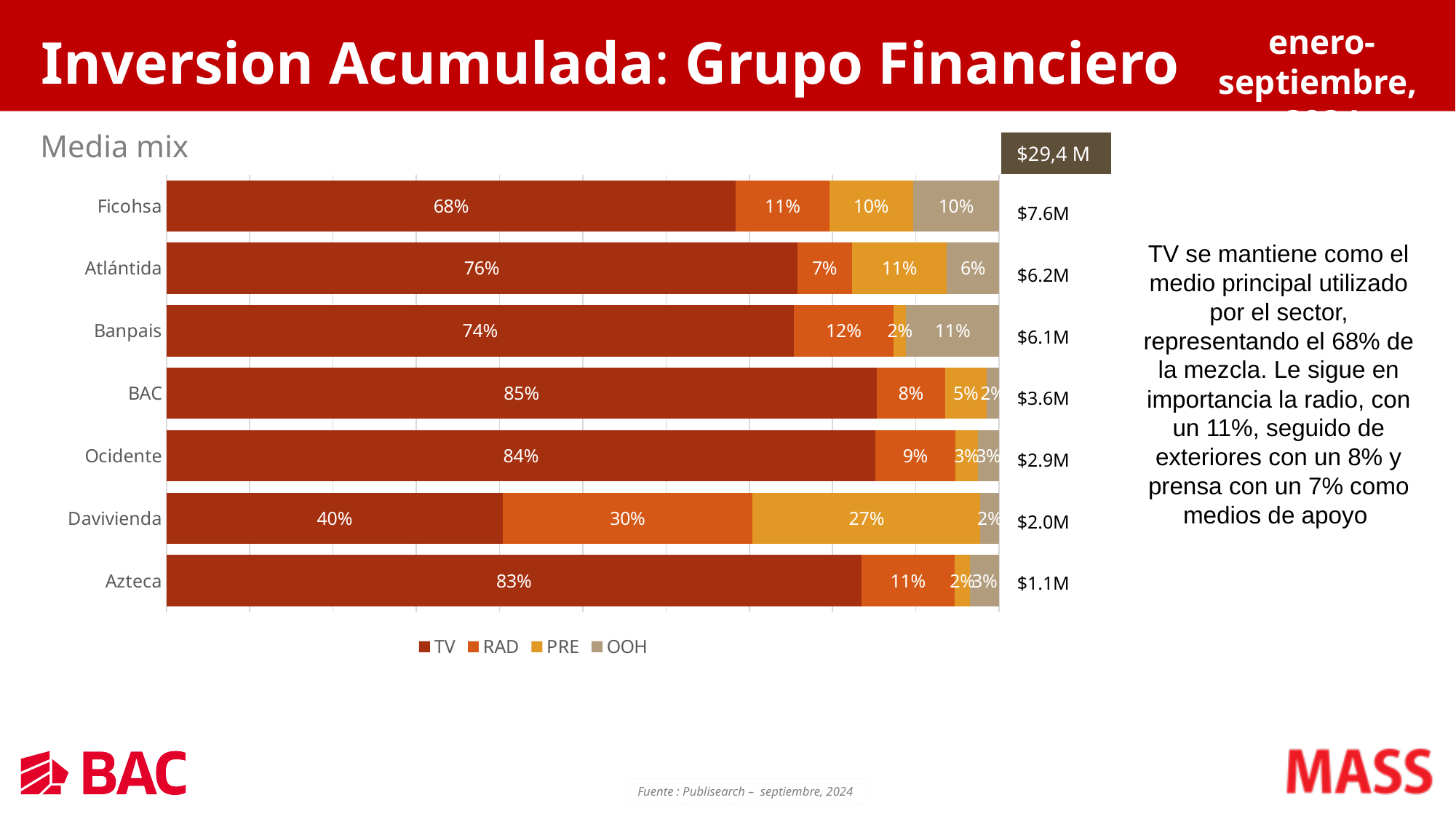
Which is larger, the RAD share for Banpais or the RAD share for Ocidente? Banpais Which category has the highest TV share? BAC What is the title of the chart? Media mix What is the difference between the TV share of Atlántida and the TV share of Ficohsa? 8% What is the RAD share for Davivienda? 30% What is the TV share for Ficohsa? 68% How many series does the legend list? 4 What is the OOH share for Banpais? 11% Which category has the lowest TV share? Davivienda What is the PRE share for Atlántida? 11% What kind of chart is shown on the slide? Stacked bar chart How many categories are shown on the chart? 7